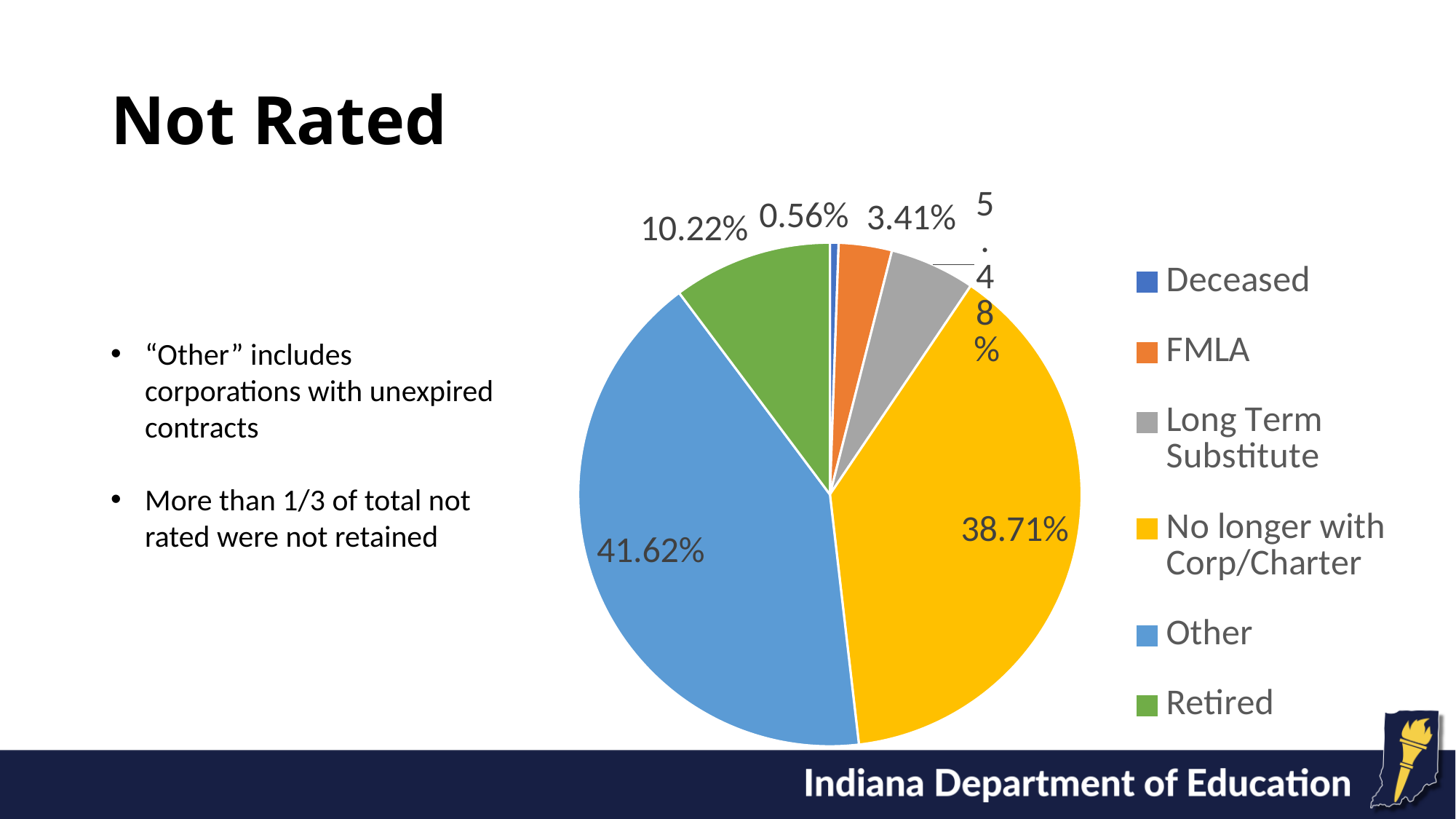
What share of the pie is labelled for FMLA? 3.41% Which category has the largest slice of the pie? Other What is the difference between the Other share and the No longer with Corp/Charter share? 2.91% How many categories does the legend list? 6 What share of the pie is labelled for Deceased? 0.56% Which category has the smallest slice of the pie? Deceased What kind of chart is shown on the slide? pie chart What share of the pie is labelled for No longer with Corp/Charter? 38.71% What share of the pie is labelled for Other? 41.62% Which is larger, the slice for Retired or the slice for FMLA? Retired What colour is the slice for Retired? green What share of the pie is labelled for Retired? 10.22%